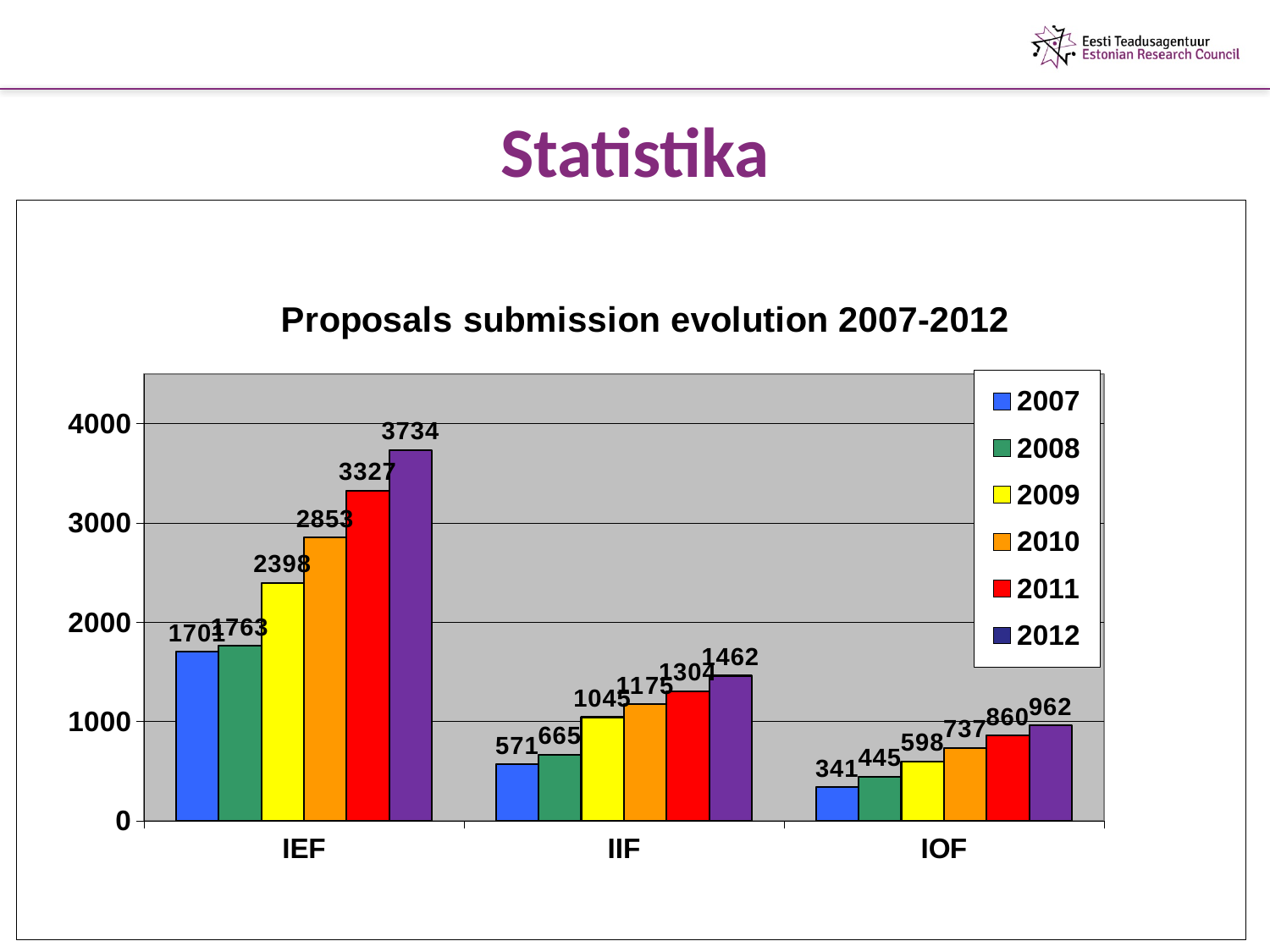
Which is larger: the IIF value for 2012 or the IOF value for 2012? IIF value for 2012 What is the value for IOF in 2007? 341 How many categories are shown on the x axis? 3 Which category has the lowest value in 2007? IOF What is the value for IOF in 2011? 860 What kind of chart is shown on the slide? Bar chart How many series does the legend list? 6 What is the title of the chart? Proposals submission evolution 2007-2012 What is the value for IEF in 2012? 3734 What is the value for IIF in 2009? 1045 Which category has the highest value in 2012? IEF What is the difference between the IEF values for 2012 and 2011? 407